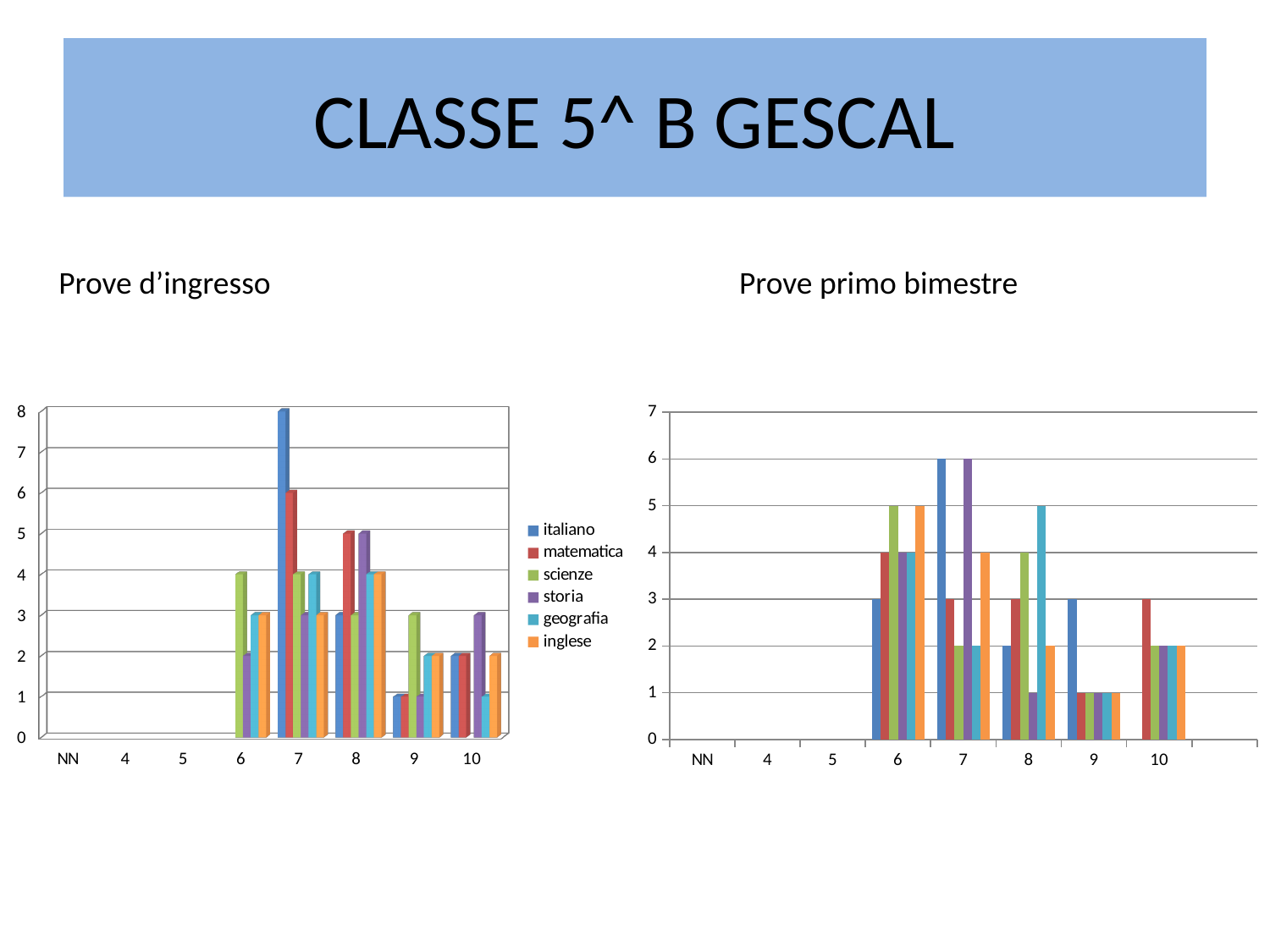
In the 'Prove primo bimestre' chart on the right, what value does the blue bar reach at category 7? 6 In the 'Prove d’ingresso' chart, what is the value for italiano at category 7? 8 In the 'Prove d’ingresso' chart, what is the value for matematica at category 8? 5 In the 'Prove d’ingresso' chart, at category 6, which is larger: scienze or storia? scienze How many series does the legend of the 'Prove d’ingresso' chart list? 6 How many categories are shown on the x axis of the 'Prove d’ingresso' chart? 8 In the 'Prove d’ingresso' chart, which category contains the tallest bar? 7 In the 'Prove primo bimestre' chart on the right, what value does the orange bar reach at category 6? 5 In the 'Prove d’ingresso' chart, what is the difference between italiano and matematica at category 7? 2 What is the highest value shown on the y axis of the 'Prove primo bimestre' chart on the right? 7 In the 'Prove d’ingresso' chart, is the value for italiano at category 7 greater or less than 6? greater What kind of chart is the 'Prove d’ingresso' chart on the left? bar chart